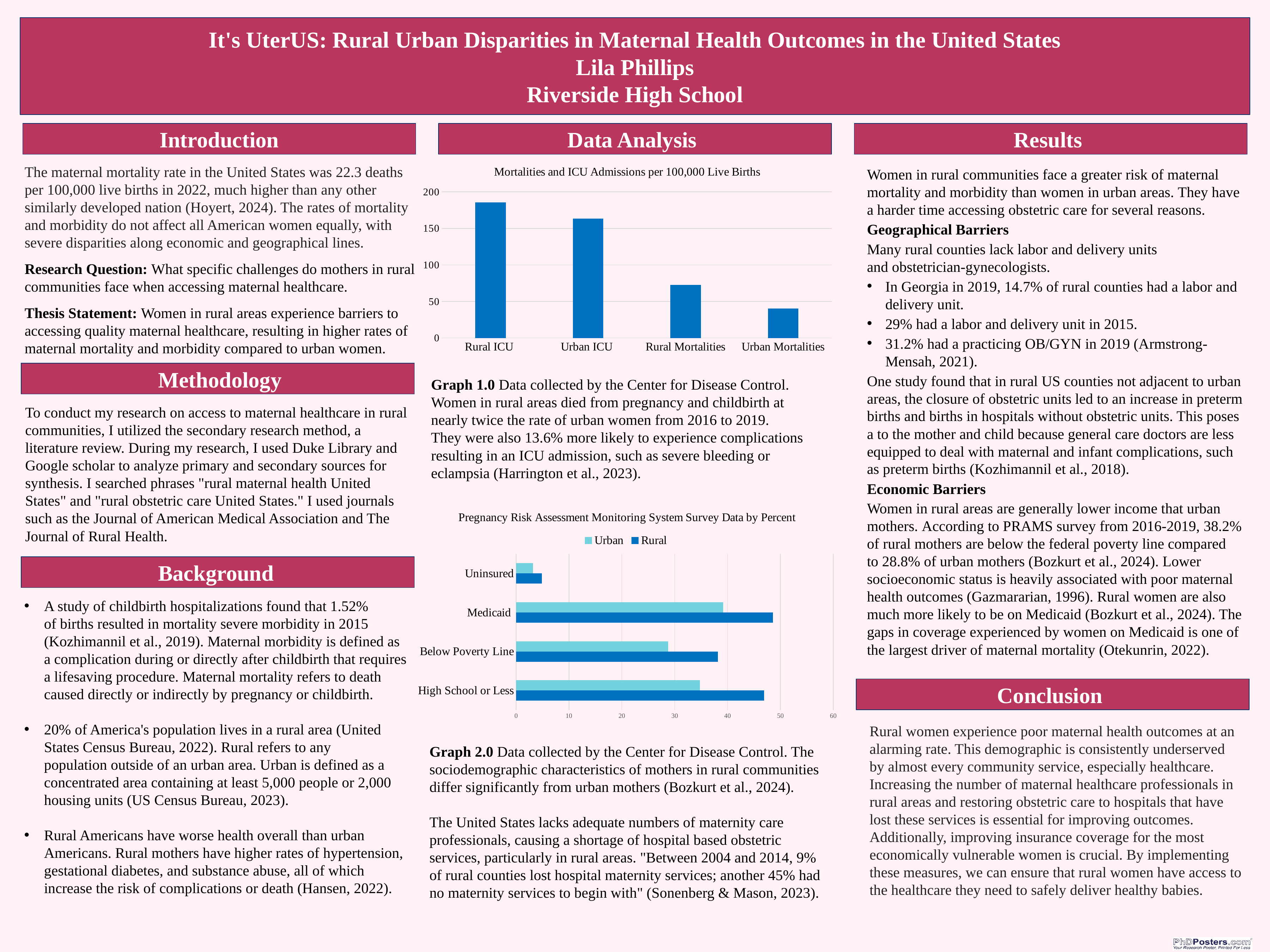
In the chart titled "Mortalities and ICU Admissions per 100,000 Live Births", is the value for Urban Mortalities greater or less than 50? less In the chart titled "Mortalities and ICU Admissions per 100,000 Live Births", which category has the highest value? Rural ICU In the chart titled "Pregnancy Risk Assessment Monitoring System Survey Data by Percent", which is larger for Below Poverty Line, Urban or Rural? Rural In the chart titled "Pregnancy Risk Assessment Monitoring System Survey Data by Percent", which category has the lowest values for both series? Uninsured In the chart titled "Mortalities and ICU Admissions per 100,000 Live Births", is the value for Rural ICU greater or less than 150? greater In the chart titled "Mortalities and ICU Admissions per 100,000 Live Births", how many categories are plotted? 4 In the chart titled "Pregnancy Risk Assessment Monitoring System Survey Data by Percent", how many series does the legend list? 2 In the chart titled "Pregnancy Risk Assessment Monitoring System Survey Data by Percent", is the Rural value for Medicaid greater or less than 40? greater In the chart titled "Mortalities and ICU Admissions per 100,000 Live Births", which is larger, Rural Mortalities or Urban Mortalities? Rural Mortalities In the chart titled "Mortalities and ICU Admissions per 100,000 Live Births", which category has the lowest value? Urban Mortalities In the chart titled "Mortalities and ICU Admissions per 100,000 Live Births", what kind of chart is shown? Bar chart In the chart titled "Pregnancy Risk Assessment Monitoring System Survey Data by Percent", what are the two series named in the legend? Urban and Rural